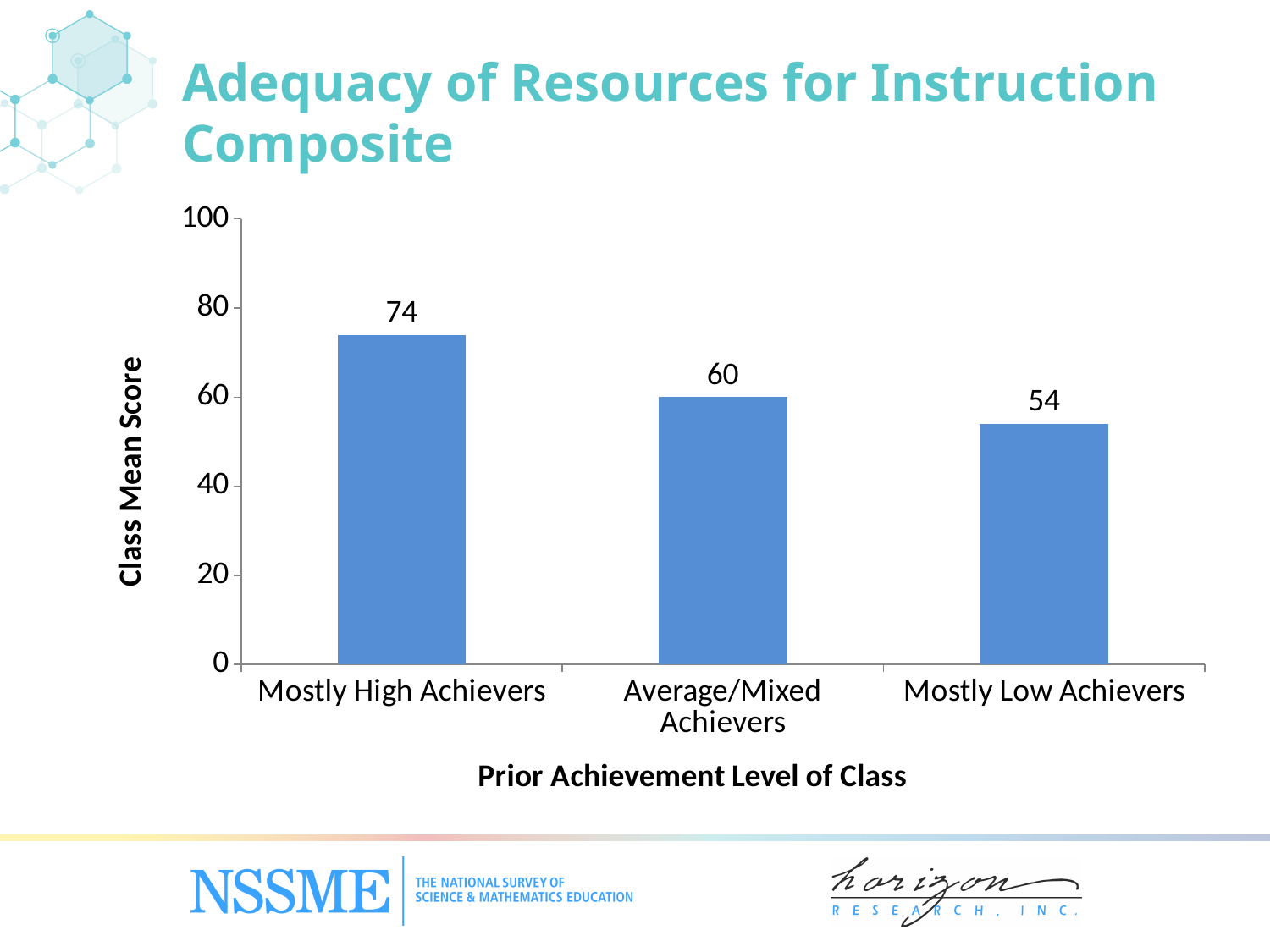
What is the class mean score for Mostly High Achievers? 74 Is the value for Mostly High Achievers greater or less than 80? less Which prior achievement level has the lowest class mean score? Mostly Low Achievers What is the difference in class mean score between Average/Mixed Achievers and Mostly Low Achievers? 6 What is the class mean score for Average/Mixed Achievers? 60 What is the class mean score for Mostly Low Achievers? 54 What kind of chart is shown on the slide? Bar chart Which prior achievement level has the highest class mean score? Mostly High Achievers What is the difference in class mean score between Mostly High Achievers and Mostly Low Achievers? 20 What is the label of the y axis? Class Mean Score How many prior achievement level categories are shown on the chart? 3 Which has a higher class mean score, Average/Mixed Achievers or Mostly Low Achievers? Average/Mixed Achievers